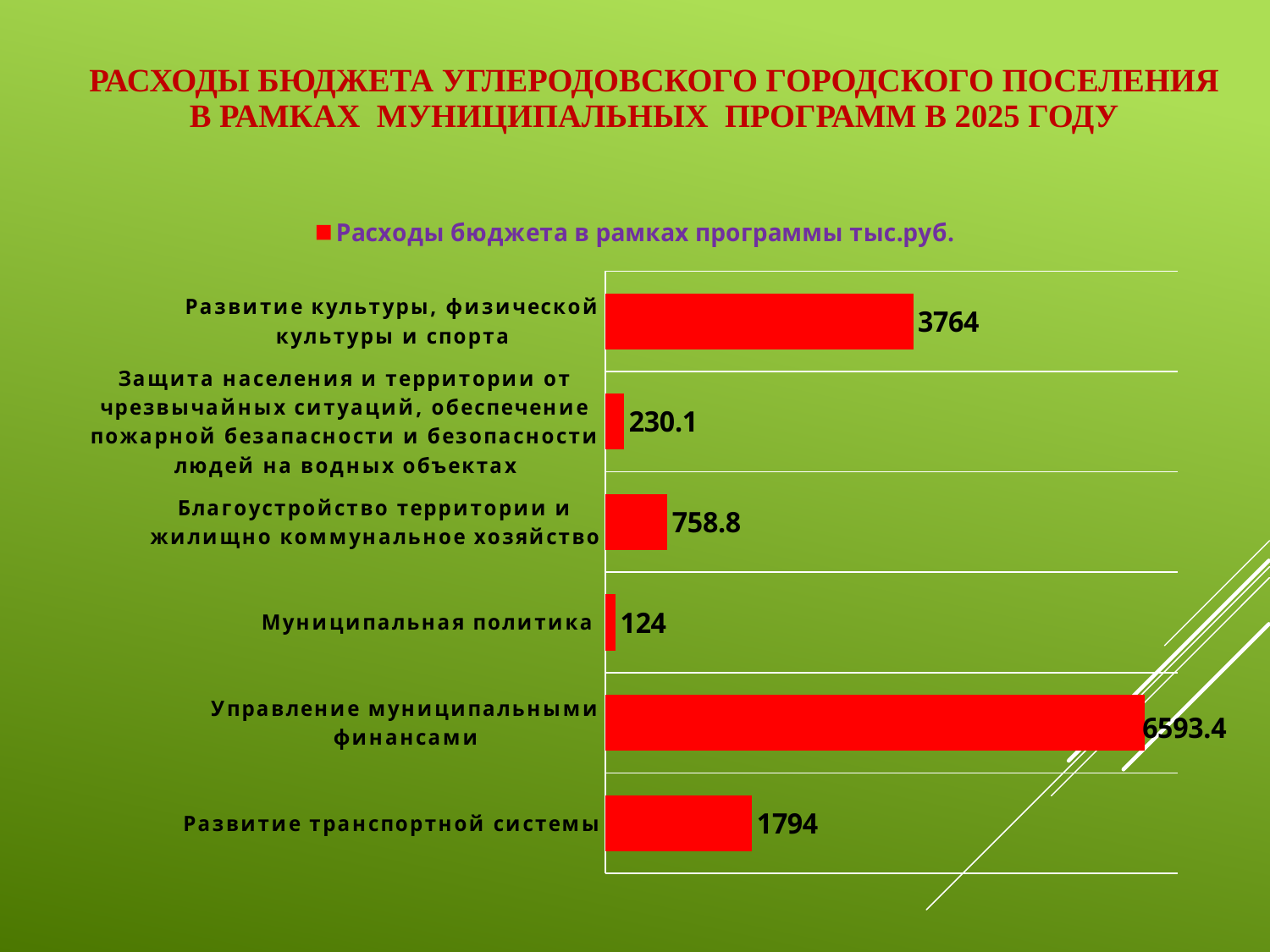
What kind of chart is shown on the slide? Bar chart How many series does the legend list? 1 What is the value for Муниципальная политика? 124 What is the legend entry of the chart? Расходы бюджета в рамках программы тыс.руб. Which is larger: the value for Благоустройство территории и жилищно коммунальное хозяйство or the value for Защита населения и территории от чрезвычайных ситуаций, обеспечение пожарной безапасности и безопасности людей на водных объектах? Благоустройство территории и жилищно коммунальное хозяйство What is the value for Управление муниципальными финансами? 6593.4 What is the difference between the values for Управление муниципальными финансами and Развитие культуры, физической культуры и спорта? 2829.4 What is the value for Развитие культуры, физической культуры и спорта? 3764 Which category has the highest value? Управление муниципальными финансами Which category has the lowest value? Муниципальная политика What is the value for Развитие транспортной системы? 1794 How many categories are shown in the chart? 6